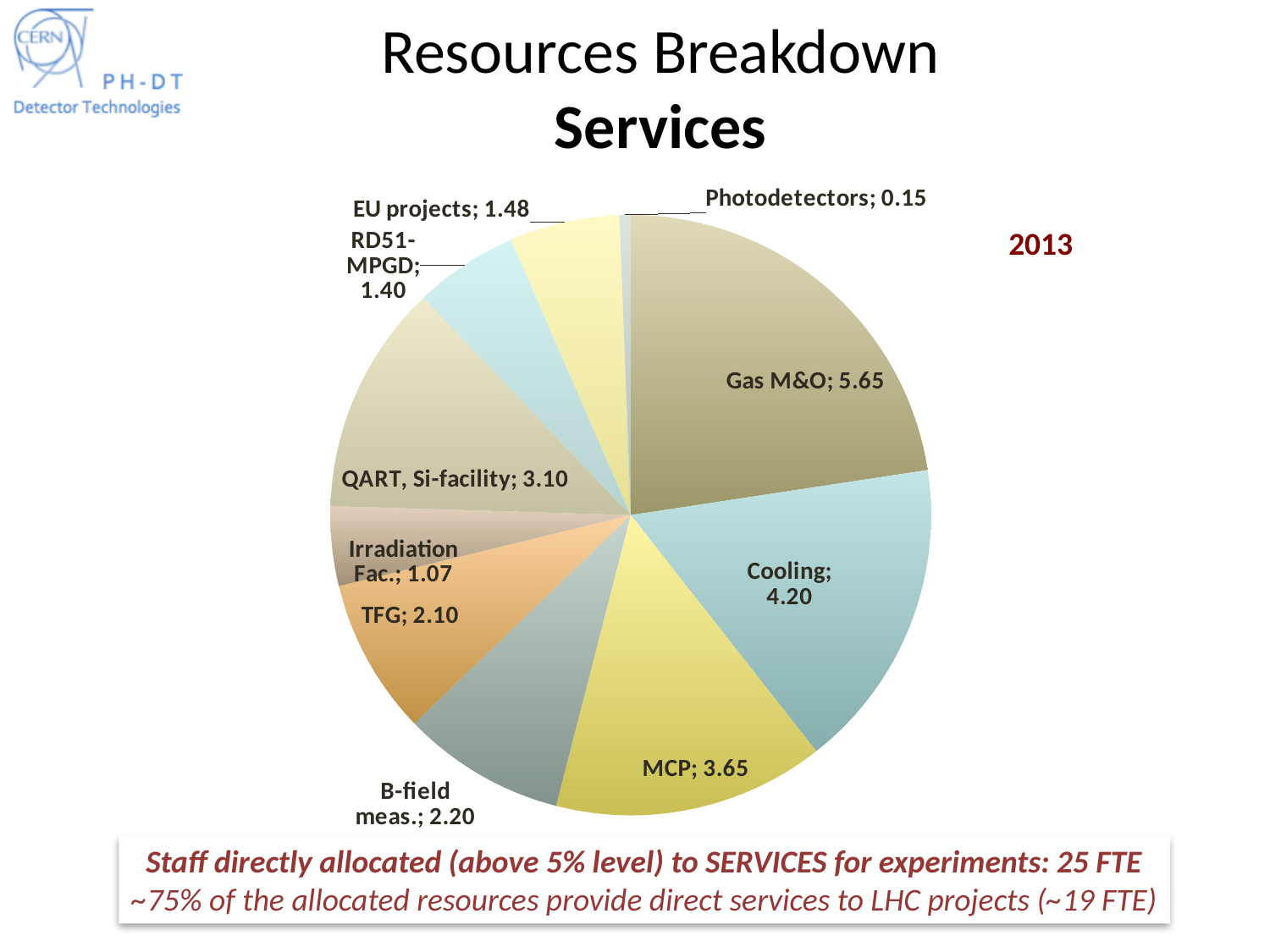
Which has a larger value, MCP or B-field meas.? MCP What is the total of all the slice values in the pie chart? 25.00 What is the difference between the values for Gas M&O and Cooling? 1.45 What value is shown for Cooling in the pie chart? 4.20 Which slice of the pie chart has the smallest value? Photodetectors What value is shown for Irradiation Fac. in the pie chart? 1.07 What kind of chart is shown on the slide? Pie chart How many slices does the pie chart have? 10 Which slice of the pie chart has the largest value? Gas M&O What value is shown for Gas M&O in the pie chart? 5.65 What value is shown for QART, Si-facility in the pie chart? 3.10 What year is indicated next to the pie chart? 2013